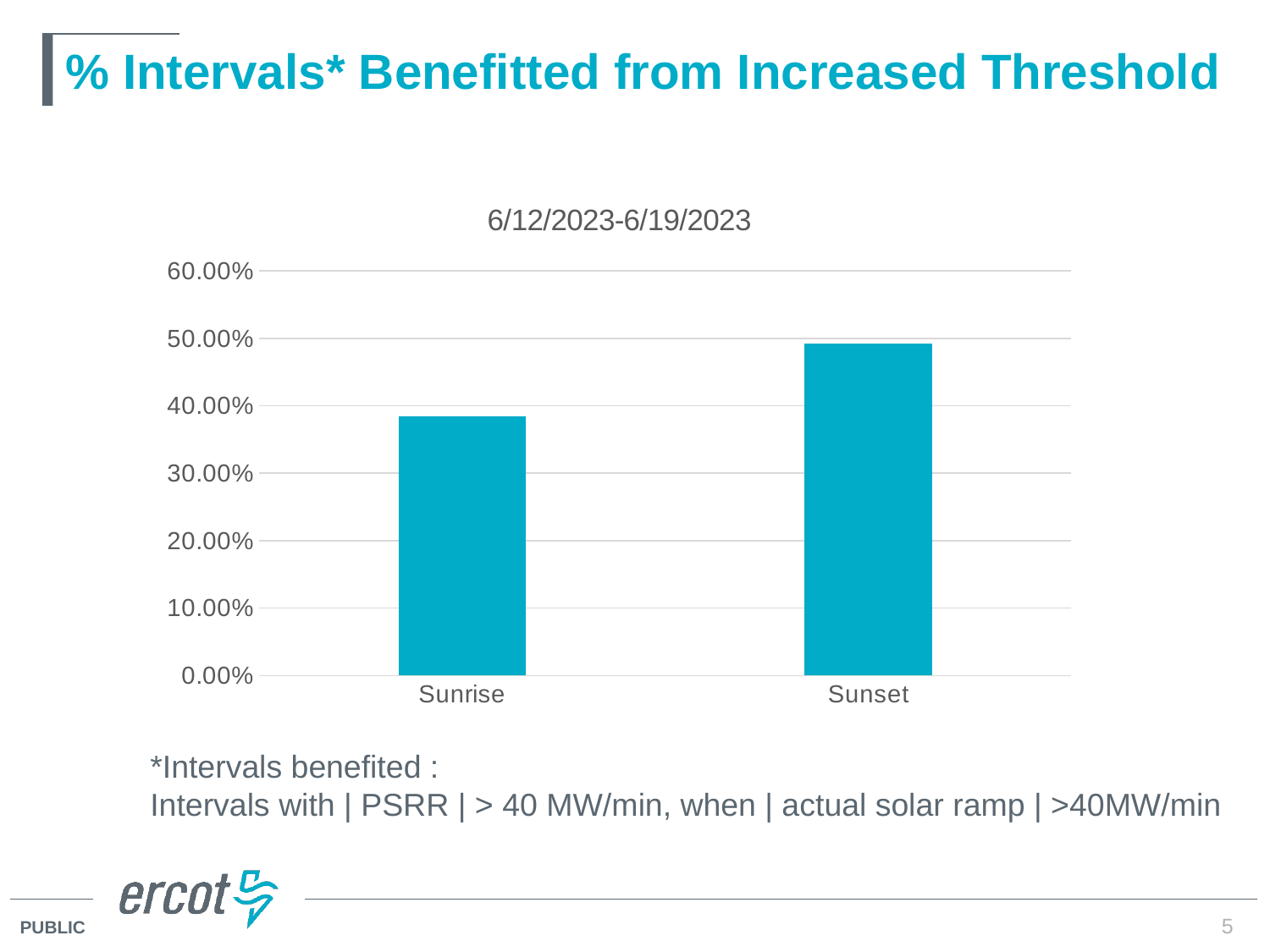
Is the value for Sunset greater or less than 40.00%? greater What is the title shown above the chart? 6/12/2023-6/19/2023 Is the value for Sunrise greater or less than 40.00%? less Which category has the lowest value in the chart? Sunrise Is the value for Sunset greater or less than 60.00%? less How many categories are shown on the x axis of the chart? 2 Which is larger, the value for Sunrise or the value for Sunset? Sunset What kind of chart is shown on the slide? bar chart Which category has the highest value in the chart? Sunset Do the values rise or fall going from Sunrise to Sunset? rise What is the highest value labelled on the chart's y axis? 60.00%